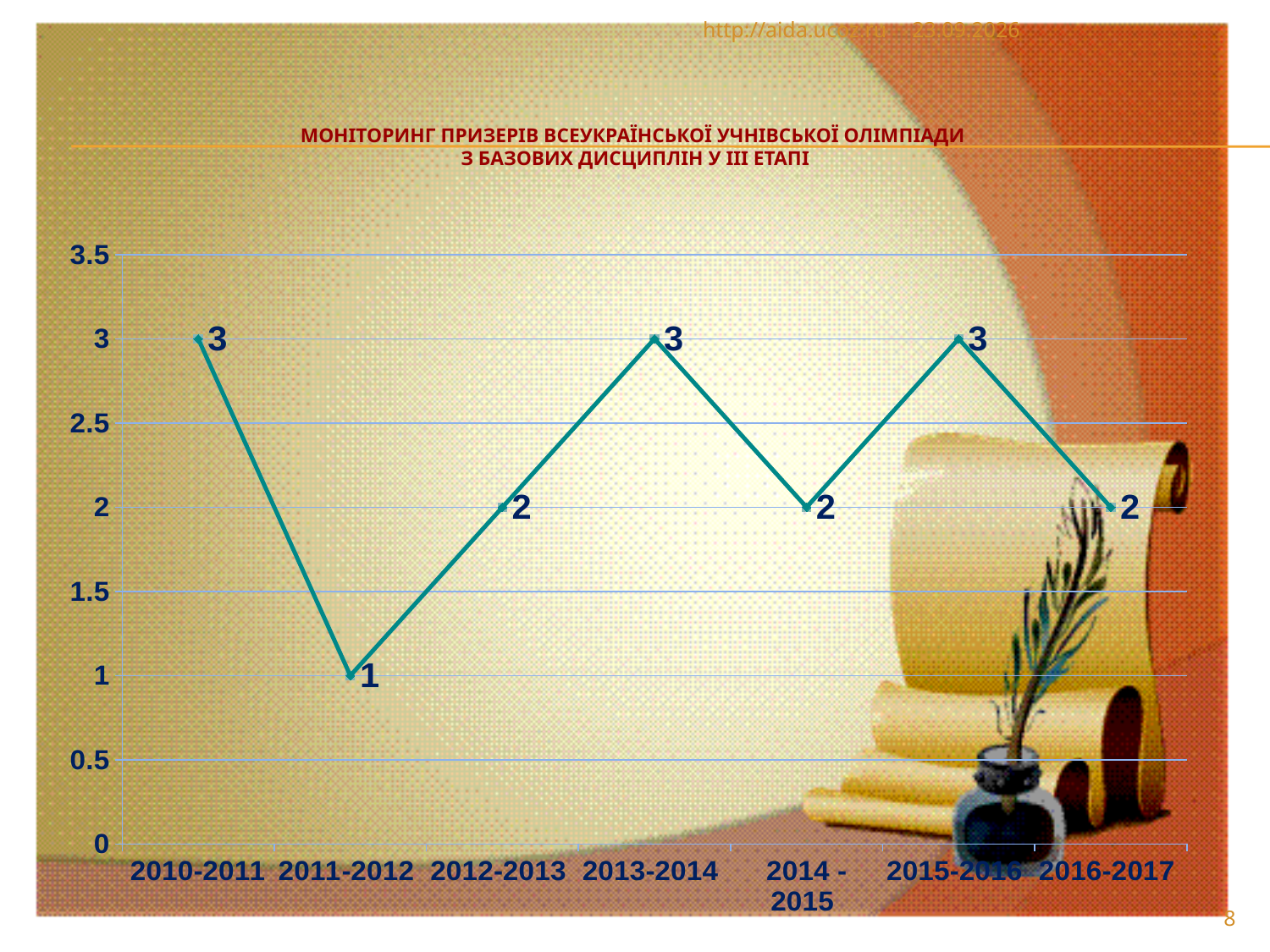
Does the value rise or fall from 2011-2012 to 2012-2013? rise What type of chart is shown on the slide? line chart What is the value for 2016-2017? 2 What is the value for 2010-2011? 3 Which year has the lowest value? 2011-2012 What is the value for 2011-2012? 1 Which is larger, the value for 2013-2014 or the value for 2014-2015? 2013-2014 Is the value for 2015-2016 greater or less than 2.5? greater What is the highest value shown on the vertical axis? 3.5 How many data points are plotted on the chart? 7 What is the difference between the values for 2010-2011 and 2011-2012? 2 What is the value for 2012-2013? 2